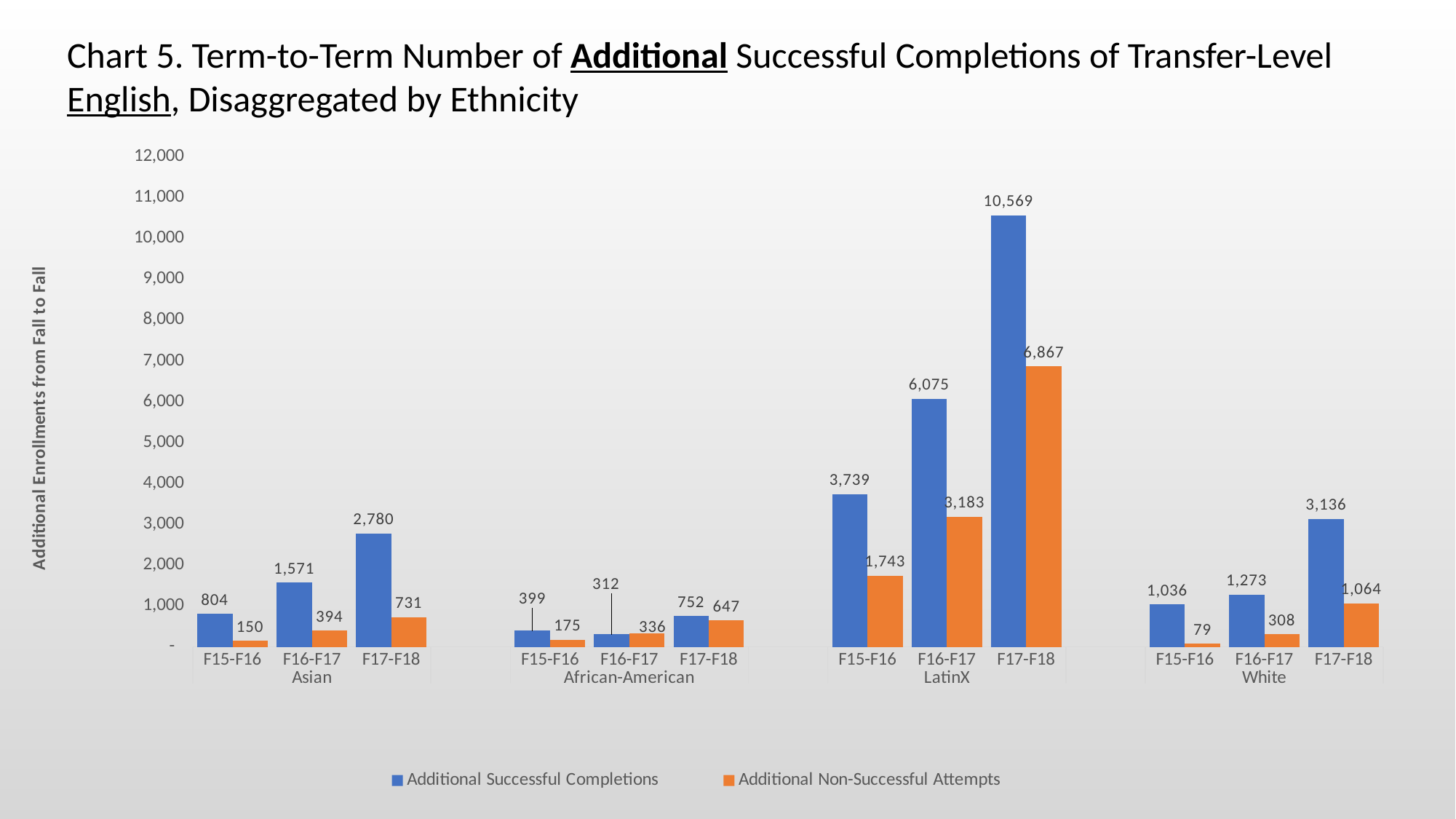
What is the label of the vertical axis? Additional Enrollments from Fall to Fall What is the difference between Additional Successful Completions and Additional Non-Successful Attempts for LatinX in F17-F18? 3,702 Which ethnicity group and term has the lowest Additional Non-Successful Attempts? White, F15-F16 What is the value of Additional Successful Completions for LatinX in F17-F18? 10,569 What is the value of Additional Non-Successful Attempts for Asian in F16-F17? 394 What kind of chart is shown on the slide? Bar chart What is the value of Additional Successful Completions for White in F15-F16? 1,036 How many ethnicity groups are shown on the x axis? 4 Which ethnicity group and term has the highest Additional Successful Completions? LatinX, F17-F18 Which is larger: Additional Successful Completions for Asian in F17-F18 or for White in F17-F18? White in F17-F18 How many series does the legend list? 2 Do the Additional Successful Completions for LatinX rise or fall from F15-F16 to F17-F18? Rise